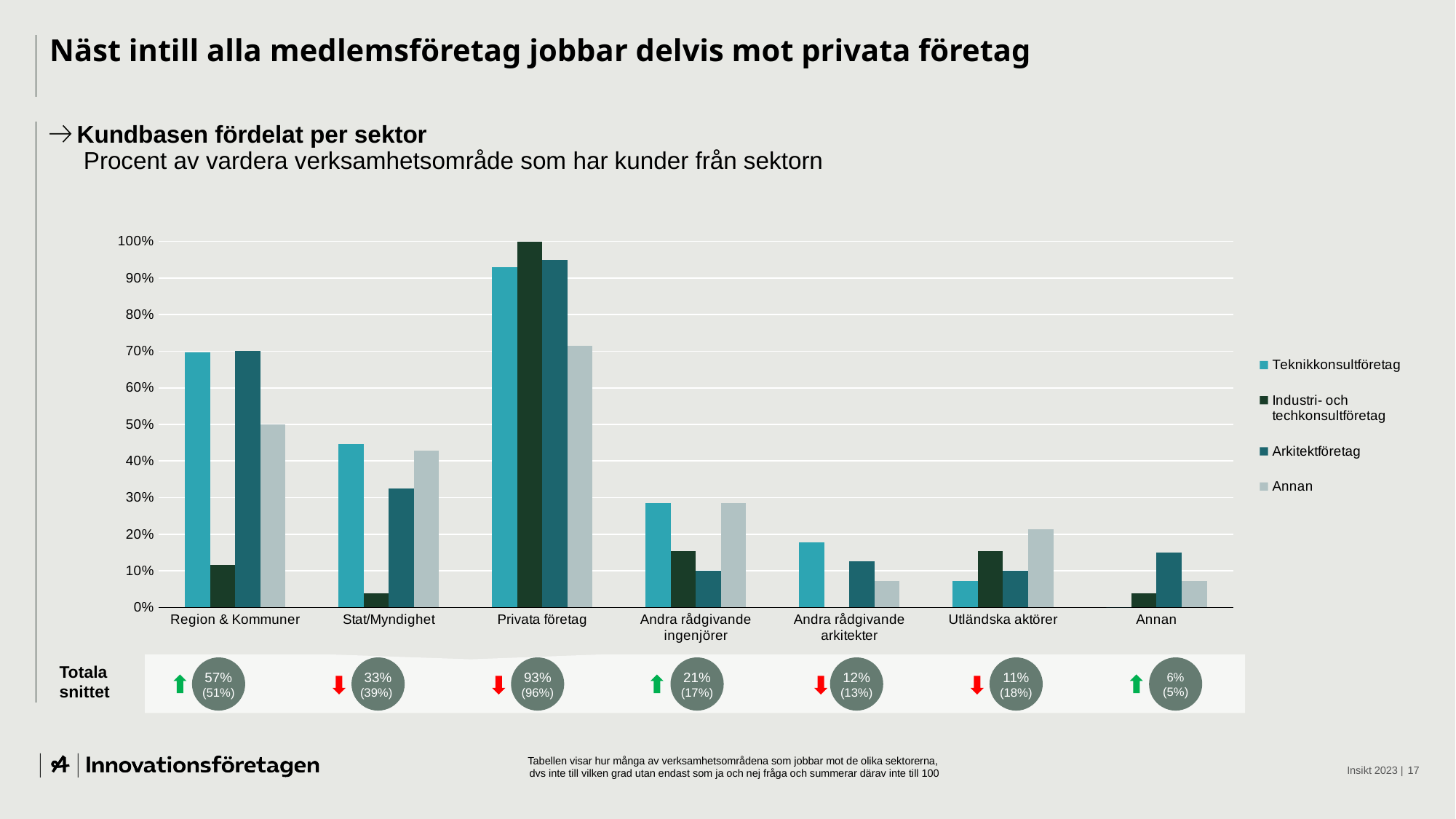
What is the value of the Industri- och techkonsultföretag bar for Privata företag? 100% What is the 'Totala snittet' value shown below the chart for Privata företag? 93% For Stat/Myndighet, which is larger: the Annan bar or the Arkitektföretag bar? Annan Is the Industri- och techkonsultföretag value for Stat/Myndighet greater or less than 10%? less How many series does the chart legend list? 4 Which category has the highest Teknikkonsultföretag bar? Privata företag What kind of chart is shown on the slide? bar chart What is the title of the chart? Kundbasen fördelat per sektor Is the Teknikkonsultföretag value for Region & Kommuner greater or less than 60%? greater Is the Annan value for Privata företag greater or less than 60%? greater How many sector categories are shown on the x axis of the chart? 7 For Utländska aktörer, which is larger: the Teknikkonsultföretag bar or the Annan bar? Annan